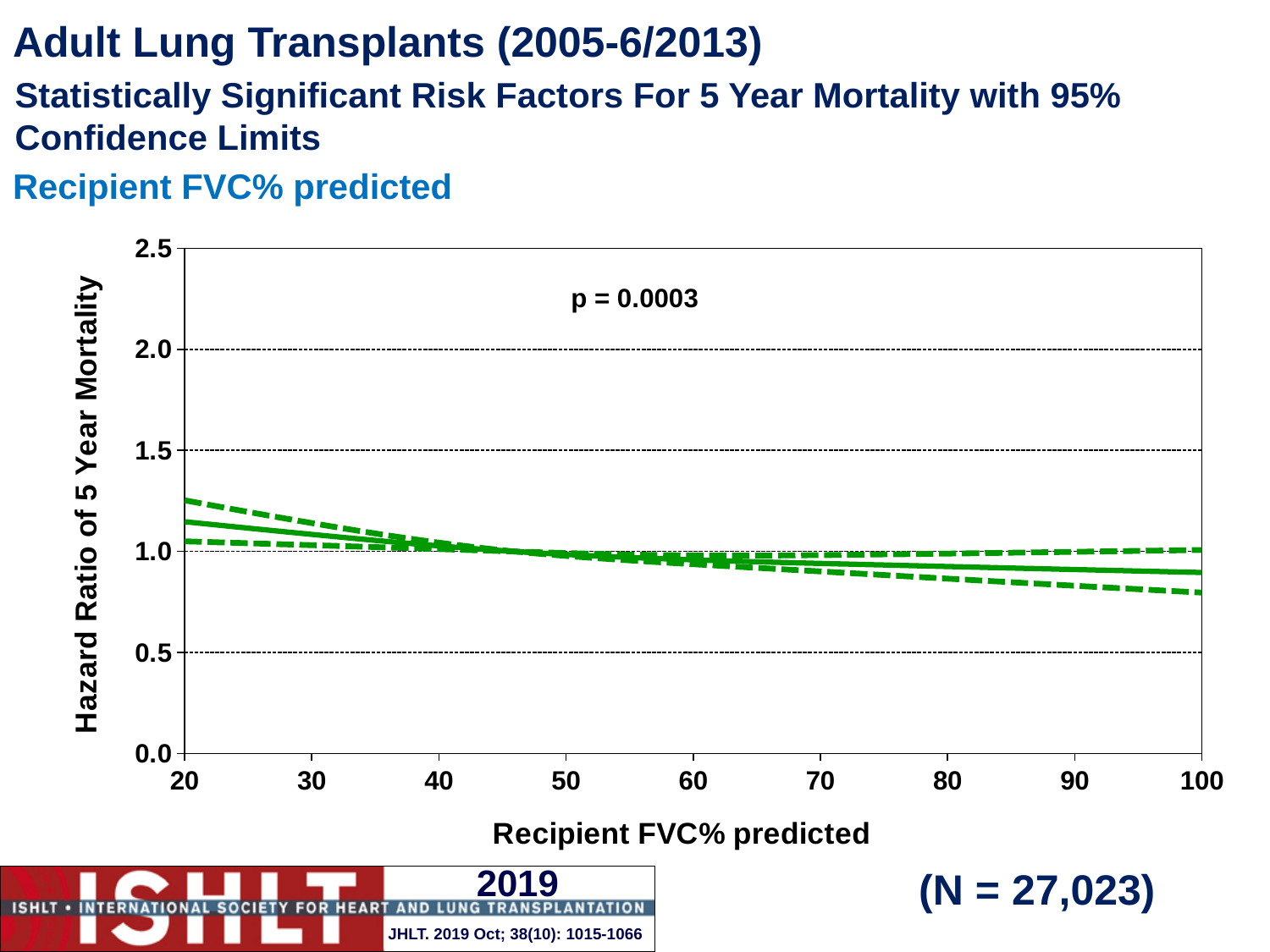
Is the upper confidence limit (upper dashed line) at Recipient FVC% predicted of 20 greater or less than 1.5? less Which has the larger hazard ratio on the solid line: Recipient FVC% predicted of 20 or 100? 20 Is the hazard ratio (solid line) at Recipient FVC% predicted of 20 greater or less than 1.0? greater Does the hazard ratio of 5 year mortality rise or fall as Recipient FVC% predicted increases from 20 to 100? fall Is the hazard ratio (solid line) at Recipient FVC% predicted of 100 greater or less than 1.0? less What p-value is shown on the chart? p = 0.0003 What kind of chart is shown on the slide? line chart How many lines are plotted on the chart? 3 What is the sample size (N) shown on the slide? N = 27,023